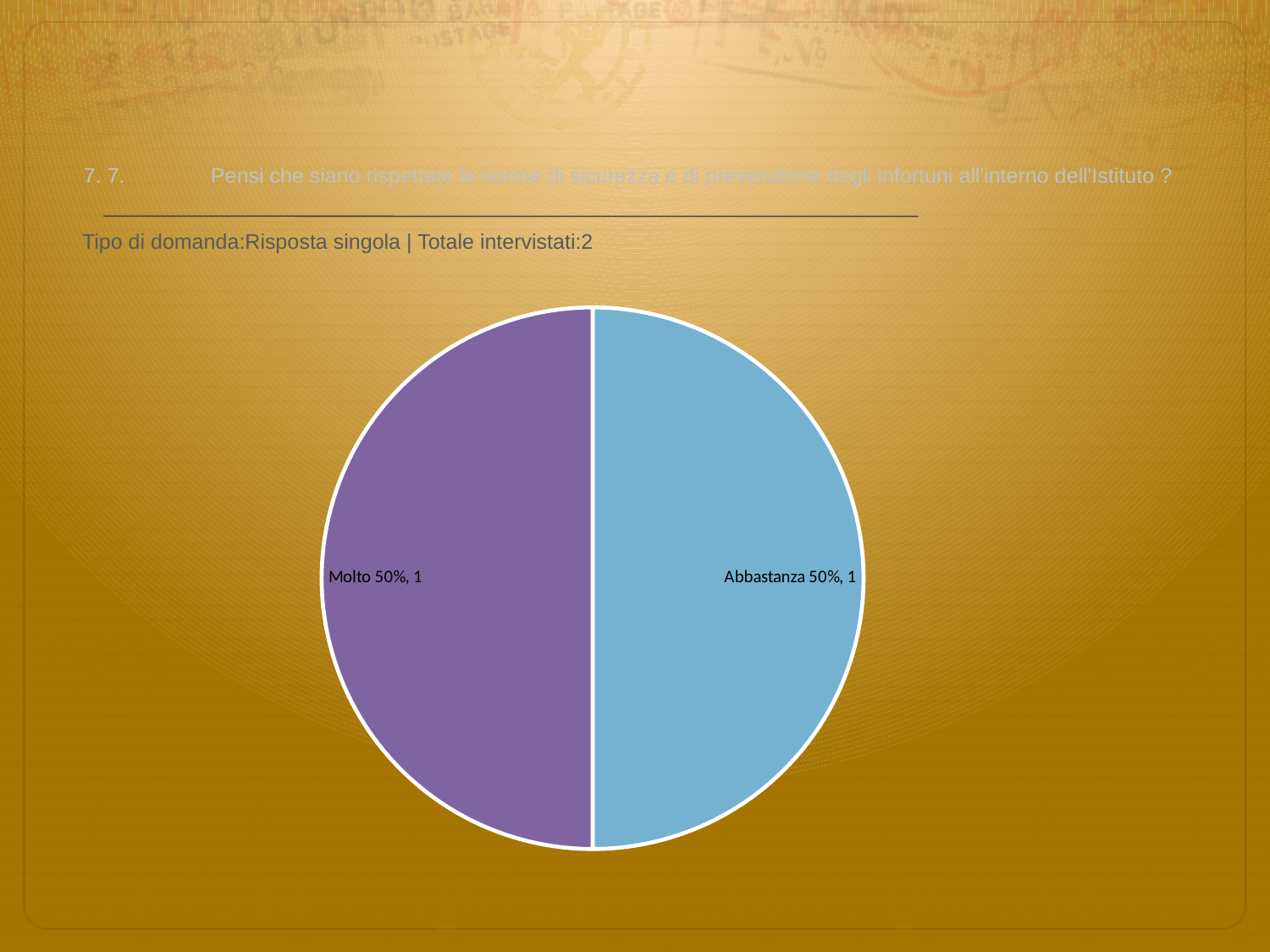
What is the count value shown for "Molto"? 1 What kind of chart is shown on the slide? pie chart What percentage share does the "Molto" slice have? 50% What is the total of the values for "Molto" and "Abbastanza"? 2 What is the count value shown for "Abbastanza"? 1 What colour is the "Molto" slice? purple What is the difference between the values for "Molto" and "Abbastanza"? 0 What colour is the "Abbastanza" slice? blue How many slices does the pie chart have? 2 According to the slide, what is the total number of respondents (Totale intervistati)? 2 What percentage share does the "Abbastanza" slice have? 50%